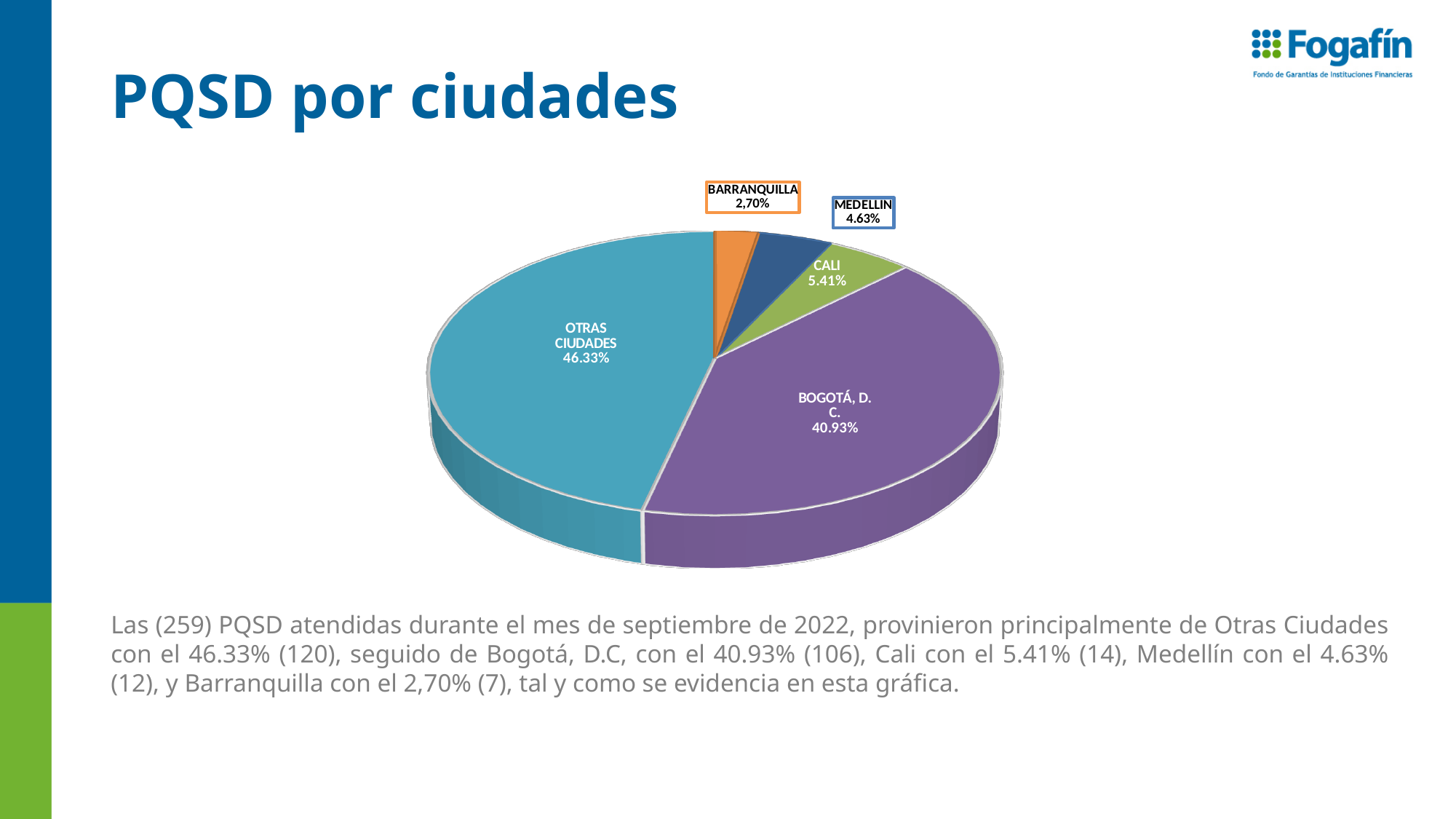
Which has a larger share, CALI or MEDELLIN? CALI What share of the pie does BARRANQUILLA represent? 2,70% What is the difference in percentage points between OTRAS CIUDADES and BOGOTÁ, D. C.? 5.40 What kind of chart is shown on the slide? Pie chart What share of the pie does CALI represent? 5.41% Which city category has the largest share of the pie? OTRAS CIUDADES How many slices does the pie chart have? 5 What share of the pie does MEDELLIN represent? 4.63% What is the title of the slide containing the chart? PQSD por ciudades Which city category has the smallest share of the pie? BARRANQUILLA What share of the pie does BOGOTÁ, D. C. represent? 40.93% What share of the pie does OTRAS CIUDADES represent? 46.33%